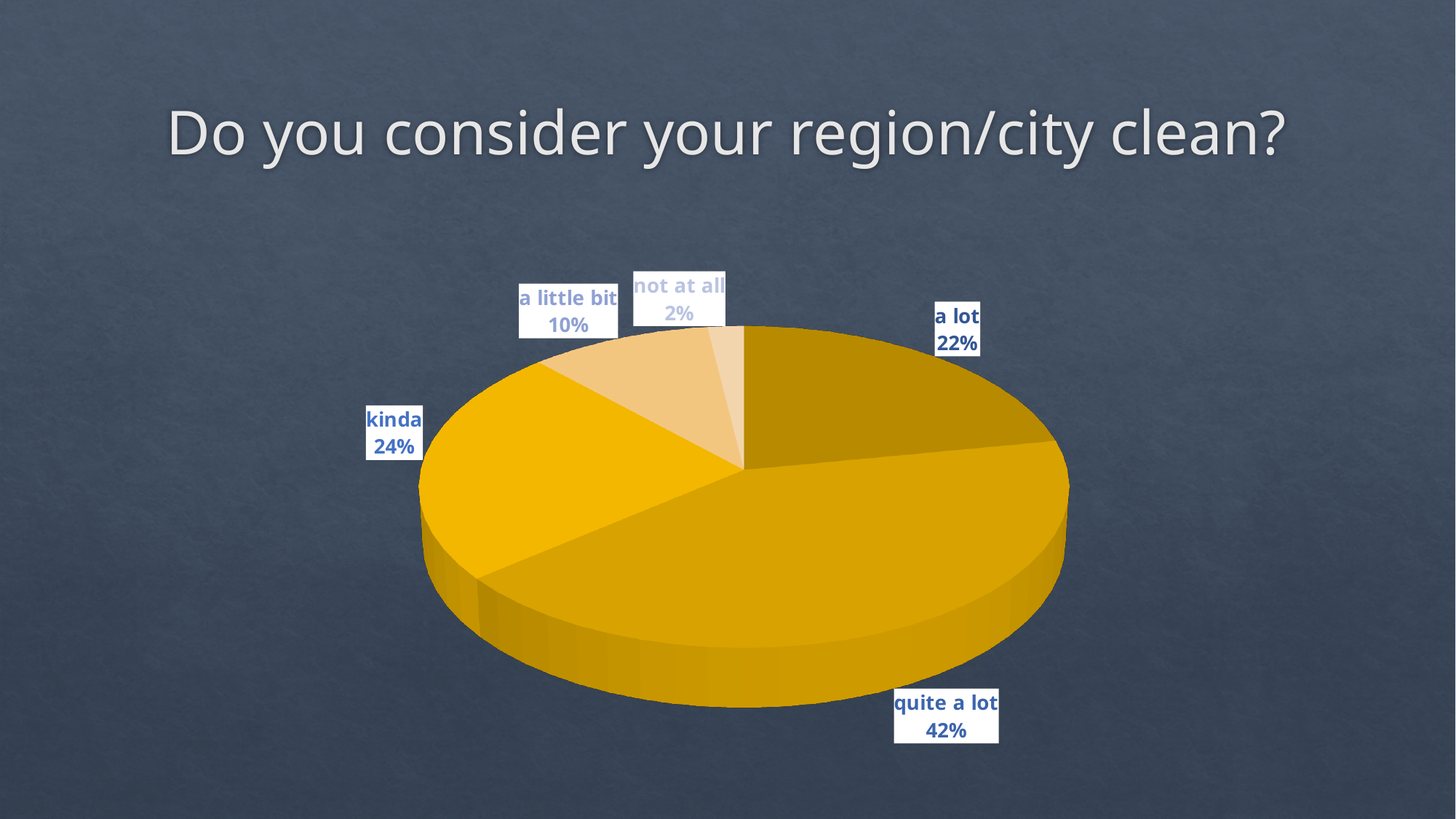
What is the combined share of "a lot" and "quite a lot"? 64% What kind of chart is shown on the slide? pie chart Which response has the largest share of the pie? quite a lot Which response has the smallest share of the pie? not at all What is the title of the chart? Do you consider your region/city clean? What percentage of respondents answered "a lot"? 22% What percentage of respondents answered "not at all"? 2% Which is larger, the share for "a little bit" or the share for "a lot"? a lot What is the difference in percentage points between "quite a lot" and "kinda"? 18 What percentage of respondents answered "quite a lot"? 42% How many slices does the pie chart have? 5 What percentage of respondents answered "kinda"? 24%